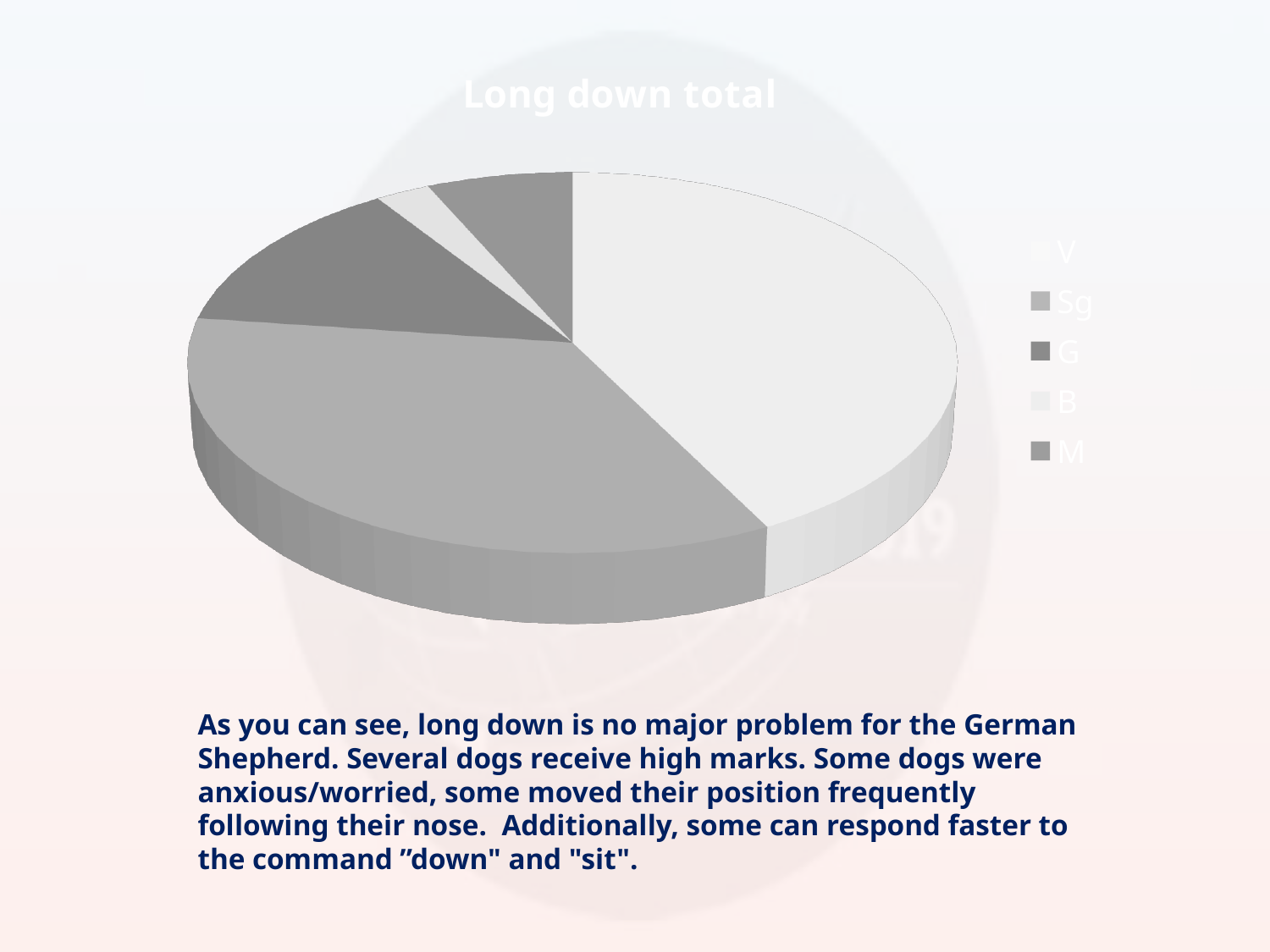
Which category has the smallest slice of the pie? B Which slice is larger, V or Sg? V Which category is listed first in the legend? V How many categories does the legend of the pie chart list? 5 What is the title of the chart? Long down total Which category has the largest slice of the pie? V Which slice is larger, Sg or G? Sg Which slice is larger, M or B? M What kind of chart is shown on the slide? pie chart